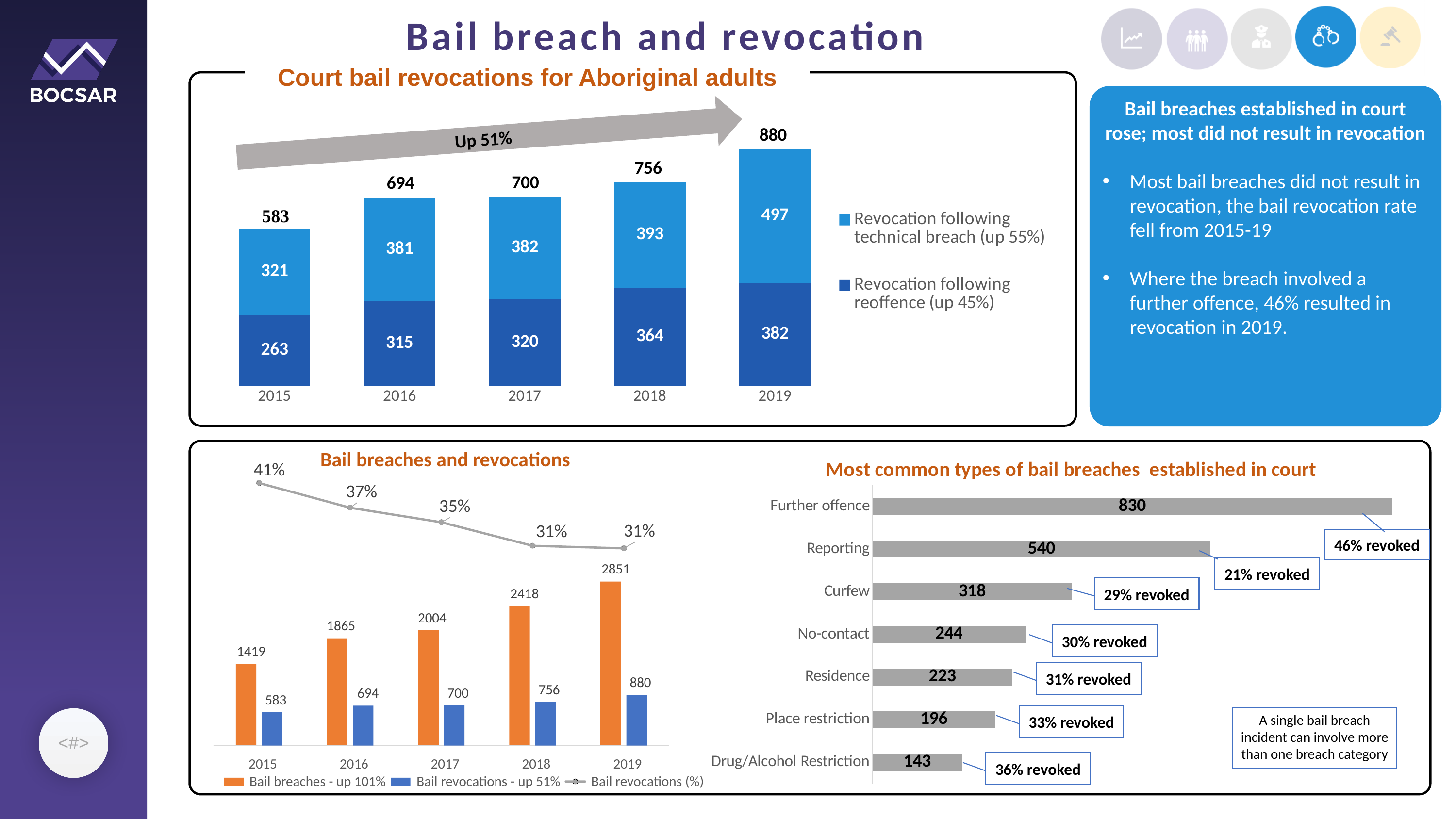
In the 'Court bail revocations for Aboriginal adults' chart, what is the value for revocation following technical breach in 2019? 497 In the 'Most common types of bail breaches established in court' chart, what is the value for Curfew? 318 In the 'Bail breaches and revocations' chart, does the bail revocations (%) line rise or fall from 2015 to 2019? fall In the 'Court bail revocations for Aboriginal adults' chart, how many series does the legend list? 2 What kind of chart is 'Most common types of bail breaches established in court'? bar chart In the 'Court bail revocations for Aboriginal adults' chart, which year has the lowest total? 2015 In the 'Court bail revocations for Aboriginal adults' chart, what is the difference between revocation following reoffence in 2019 and in 2015? 119 In the 'Bail breaches and revocations' chart, what is the bail revocations (%) value for 2015? 41% In the 'Bail breaches and revocations' chart, what is the value for bail breaches in 2018? 2418 In the 'Most common types of bail breaches established in court' chart, how many breach categories are shown? 7 In the 'Bail breaches and revocations' chart, what is the difference between bail breaches and bail revocations in 2019? 1971 In the 'Court bail revocations for Aboriginal adults' chart, what is the total of the stacked bar for 2016? 694